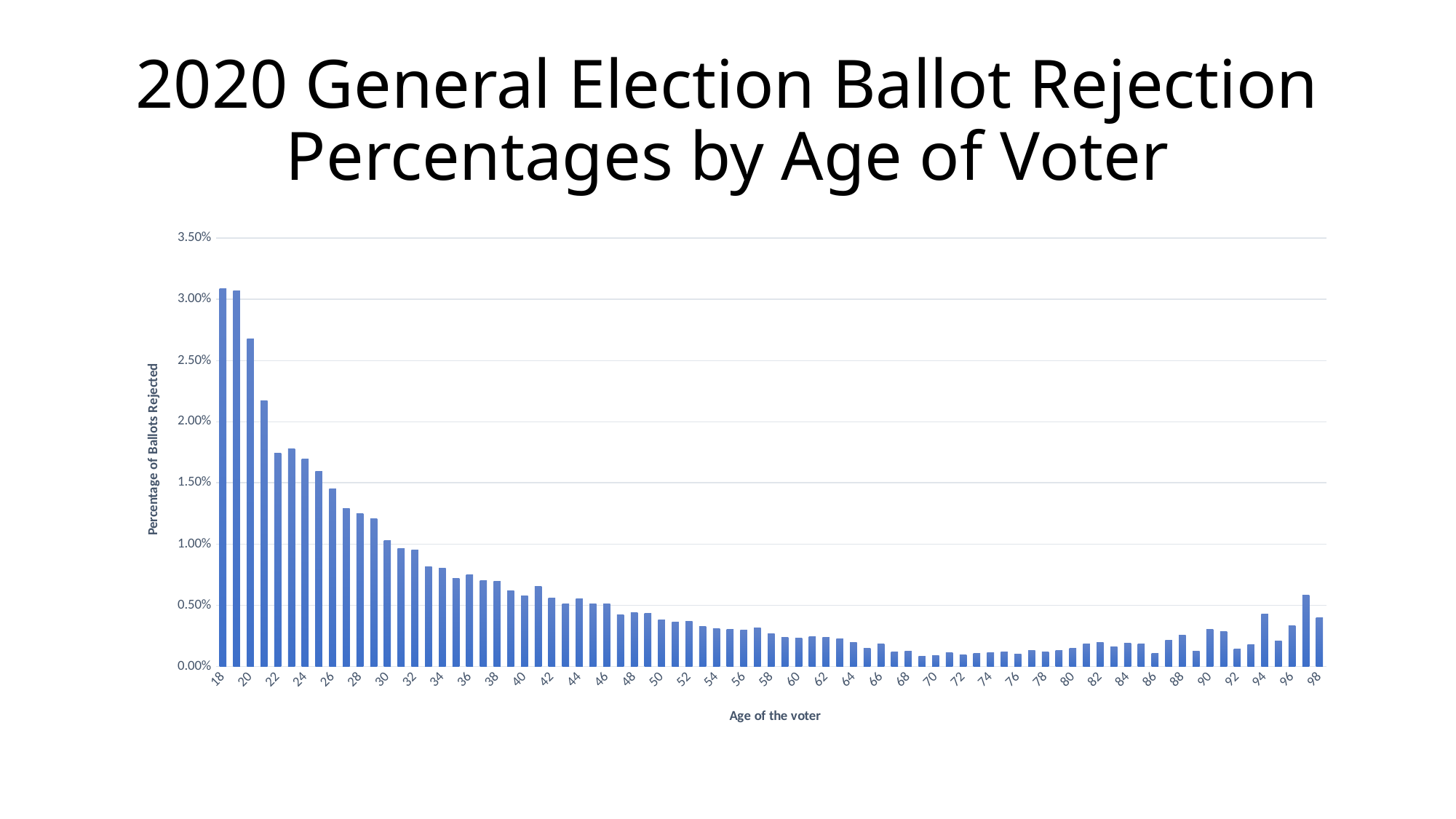
Do the ballot rejection percentages generally rise or fall as age increases from 18 to 70? fall Is the value for age 98 greater or less than 0.50%? less What is the youngest age shown on the x axis? 18 Which has a higher ballot rejection percentage, age 20 or age 30? age 20 Is the value for age 22 greater or less than 1.50%? greater Is the value for age 70 greater or less than 0.50%? less What kind of chart is shown on the slide? bar chart What is the label of the vertical axis? Percentage of Ballots Rejected Which has a higher ballot rejection percentage, age 92 or age 94? age 94 What is the title of the chart on the slide? 2020 General Election Ballot Rejection Percentages by Age of Voter